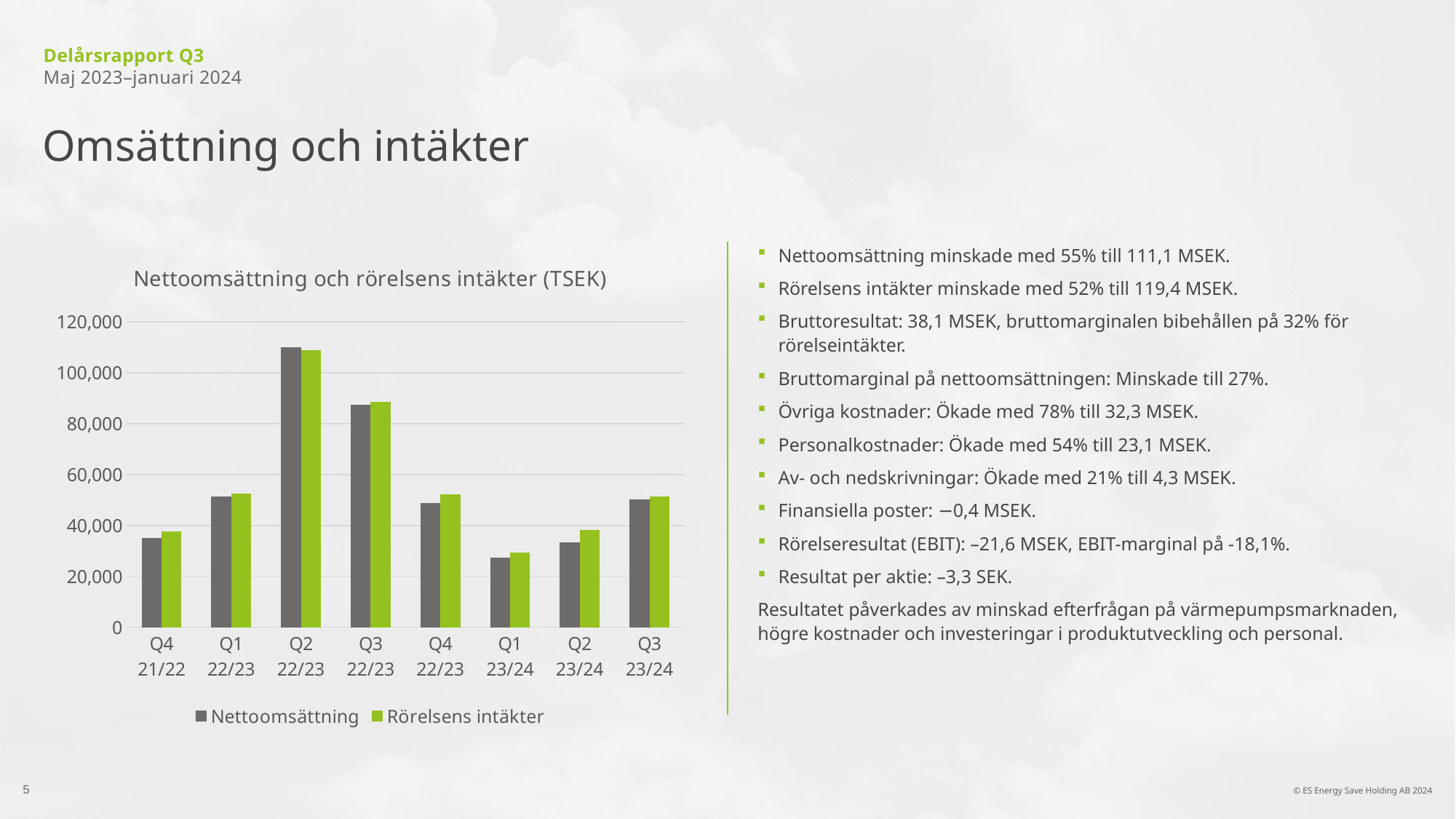
Which is larger, the Rörelsens intäkter for Q4 21/22 or for Q1 22/23? Q1 22/23 Is the Nettoomsättning value for Q1 23/24 greater or less than 40,000? less What kind of chart is shown on the slide? bar chart From Q2 22/23 to Q1 23/24, does Nettoomsättning rise or fall? fall How many series does the chart legend list? 2 Is the Rörelsens intäkter value for Q3 22/23 greater or less than 80,000? greater Which quarter has the lowest Rörelsens intäkter? Q1 23/24 What is the title of the chart? Nettoomsättning och rörelsens intäkter (TSEK) Is the Nettoomsättning value for Q2 22/23 greater or less than 100,000? greater How many quarters are shown on the x axis of the chart? 8 Which is larger, the Nettoomsättning for Q2 22/23 or for Q3 22/23? Q2 22/23 Which quarter has the highest Nettoomsättning? Q2 22/23